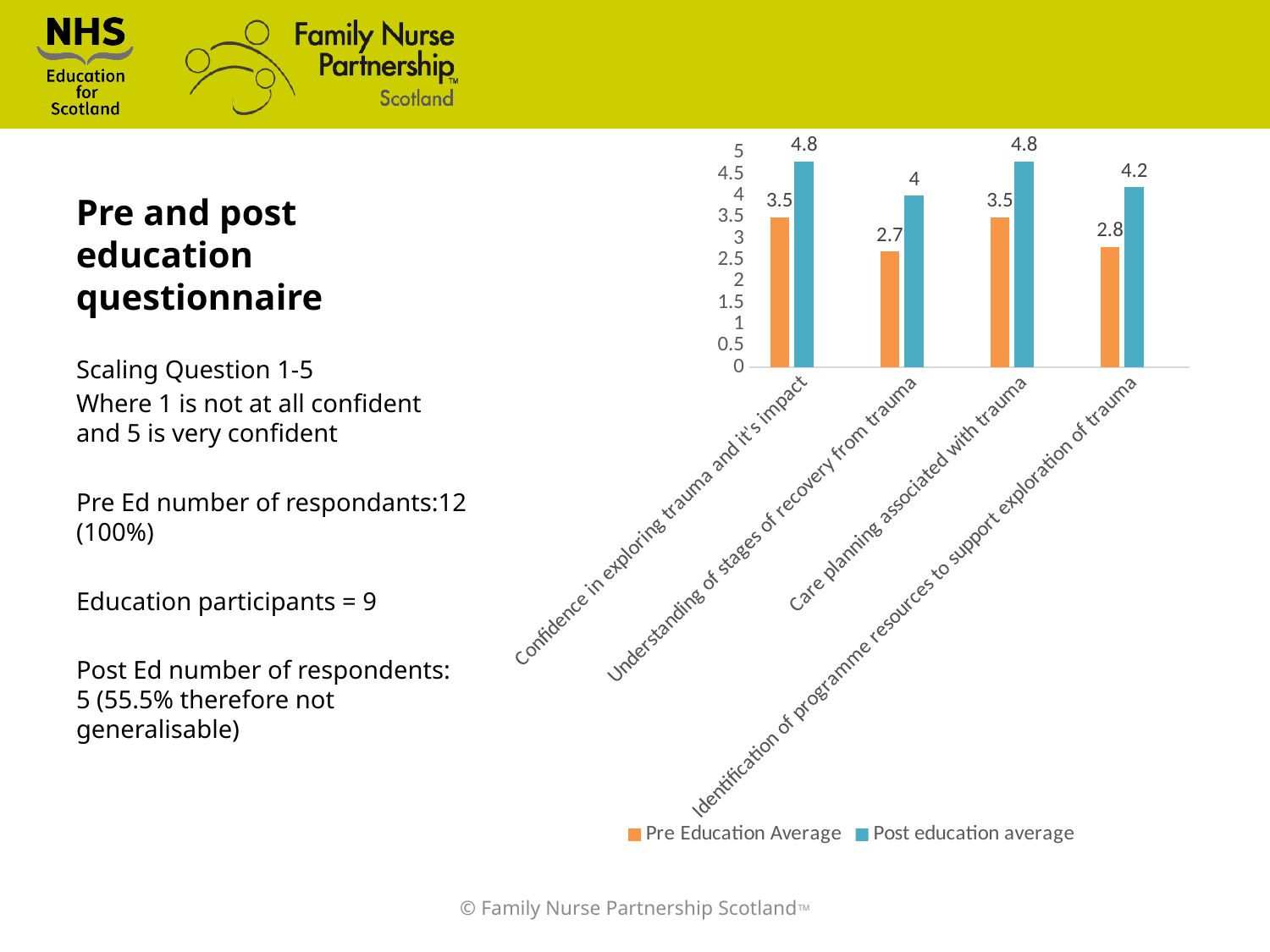
What is the difference between the Post education average and the Pre Education Average for 'Identification of programme resources to support exploration of trauma'? 1.4 How many categories are shown on the x axis of the chart? 4 What is the Post education average for 'Care planning associated with trauma'? 4.8 What kind of chart is shown on the slide? bar chart Which category has the lowest Post education average? Understanding of stages of recovery from trauma What is the Pre Education Average for 'Understanding of stages of recovery from trauma'? 2.7 What is the Post education average for 'Identification of programme resources to support exploration of trauma'? 4.2 Is the Pre Education Average for 'Care planning associated with trauma' larger or smaller than its Post education average? smaller What is the Pre Education Average for 'Confidence in exploring trauma and it's impact'? 3.5 How many series does the chart legend list? 2 Which category has the lowest Pre Education Average? Understanding of stages of recovery from trauma What is the difference between the Post education average and the Pre Education Average for 'Understanding of stages of recovery from trauma'? 1.3